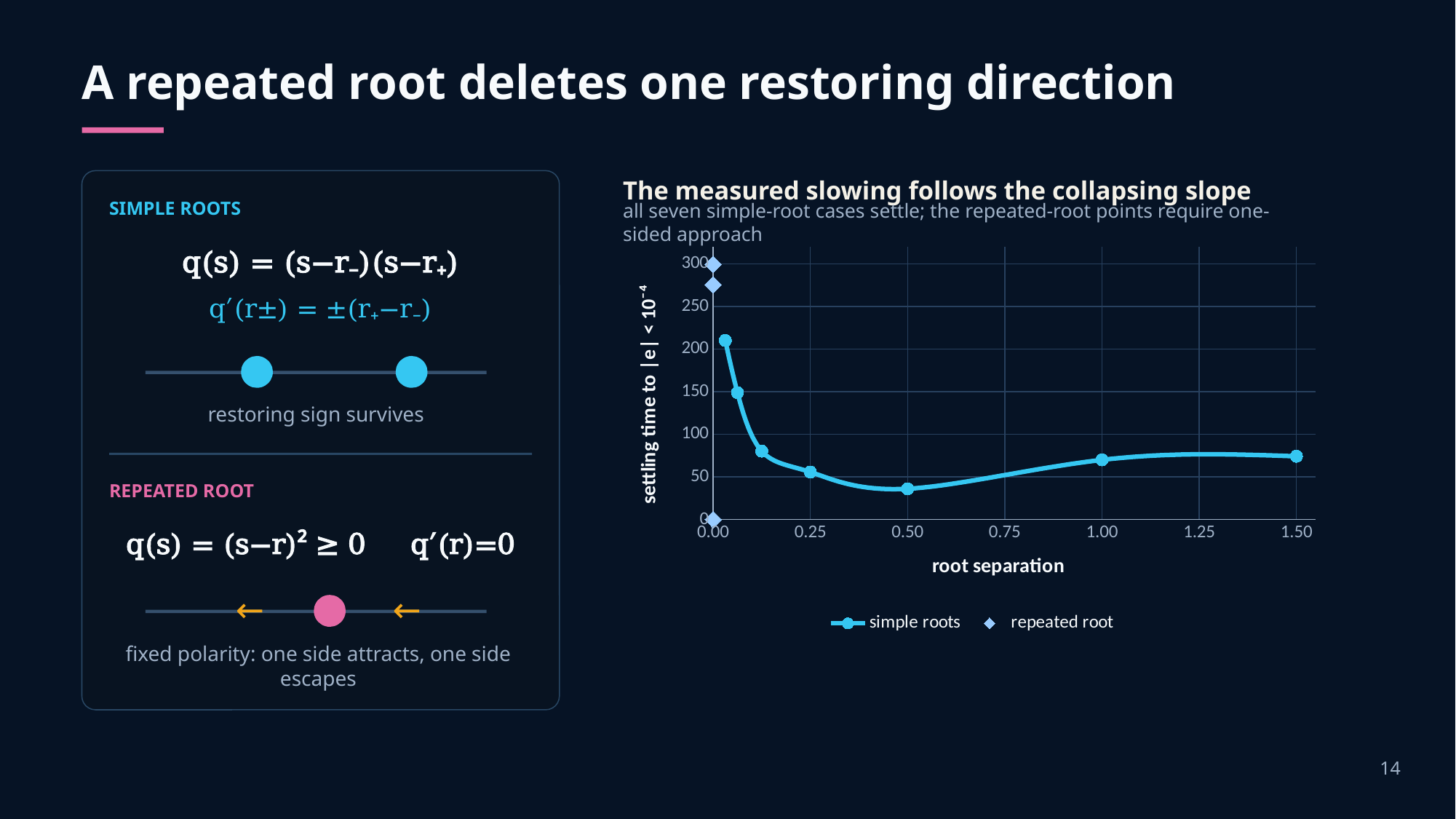
Which simple roots point has the highest settling time: the one nearest root separation 0.00 or the one at 1.50? the one nearest 0.00 At which root separation is the simple roots settling time lowest? 0.50 Is the simple roots settling time at root separation 1.50 greater or less than 100? less Is the settling time at root separation 1.00 larger or smaller than at 0.50 for the simple roots series? larger What is the label of the x axis of the chart? root separation How many series does the chart legend list? 2 What is the title of the chart? The measured slowing follows the collapsing slope Is the simple roots settling time at root separation 1.00 greater or less than 50? greater Is the simple roots settling time at root separation 0.50 greater or less than 50? less Do the simple roots settling times rise or fall as root separation increases from 0.00 to 0.50? fall What kind of chart is shown on the slide? line chart How many data points does the simple roots series have? 7